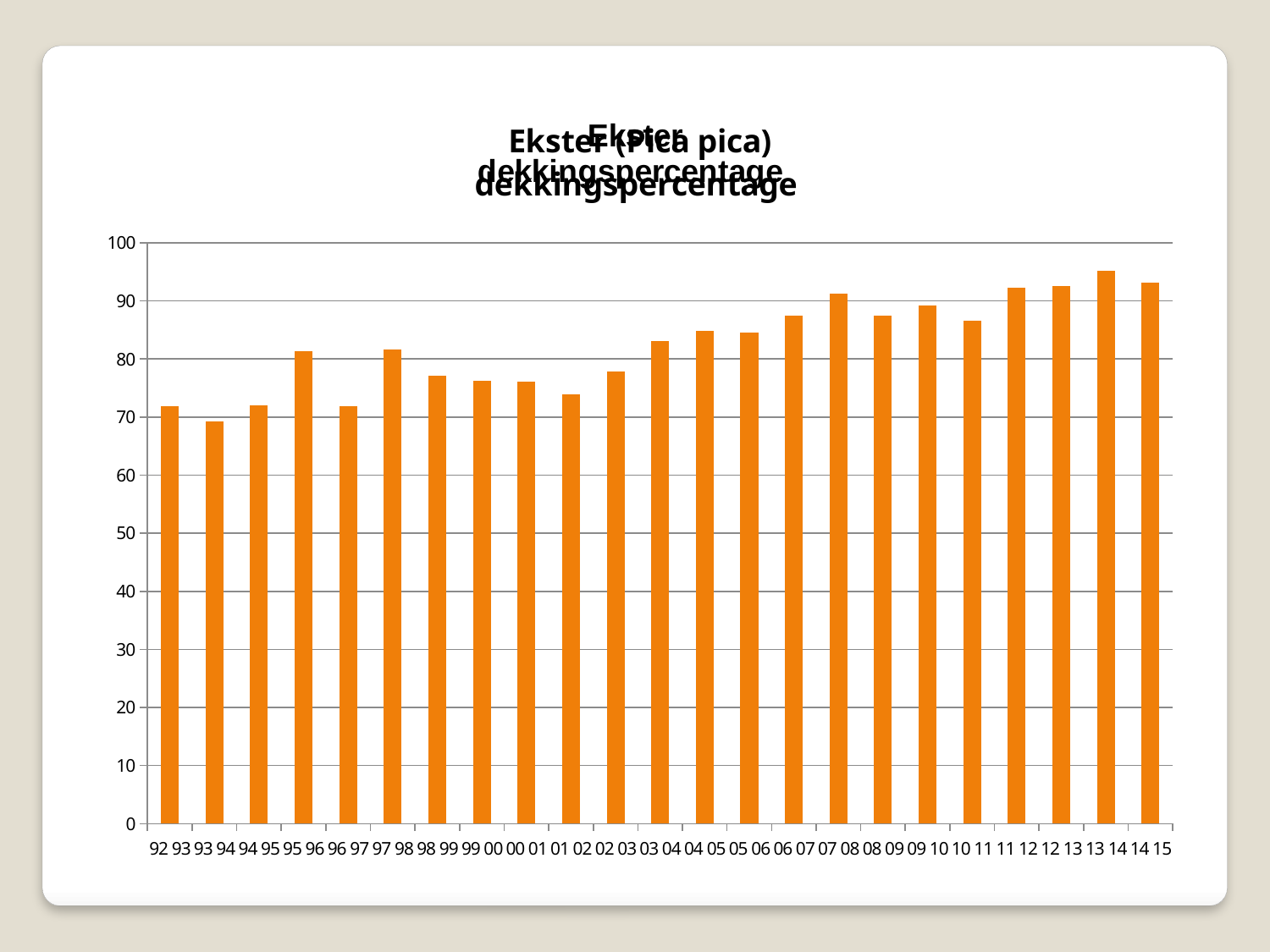
Is the value for 93 94 greater or less than 70? less Which season has the lowest bar in the chart? 93 94 Is the value for 13 14 greater or less than 90? greater What colour are the bars in the chart? orange Is the value for 95 96 greater or less than 80? greater Which is larger, the value for 95 96 or the value for 93 94? 95 96 How many bars (seasons) are plotted in the chart? 23 What kind of chart is shown on the slide? bar chart Which season has the highest bar in the chart? 13 14 Do the values generally rise or fall from 92 93 to 14 15? rise